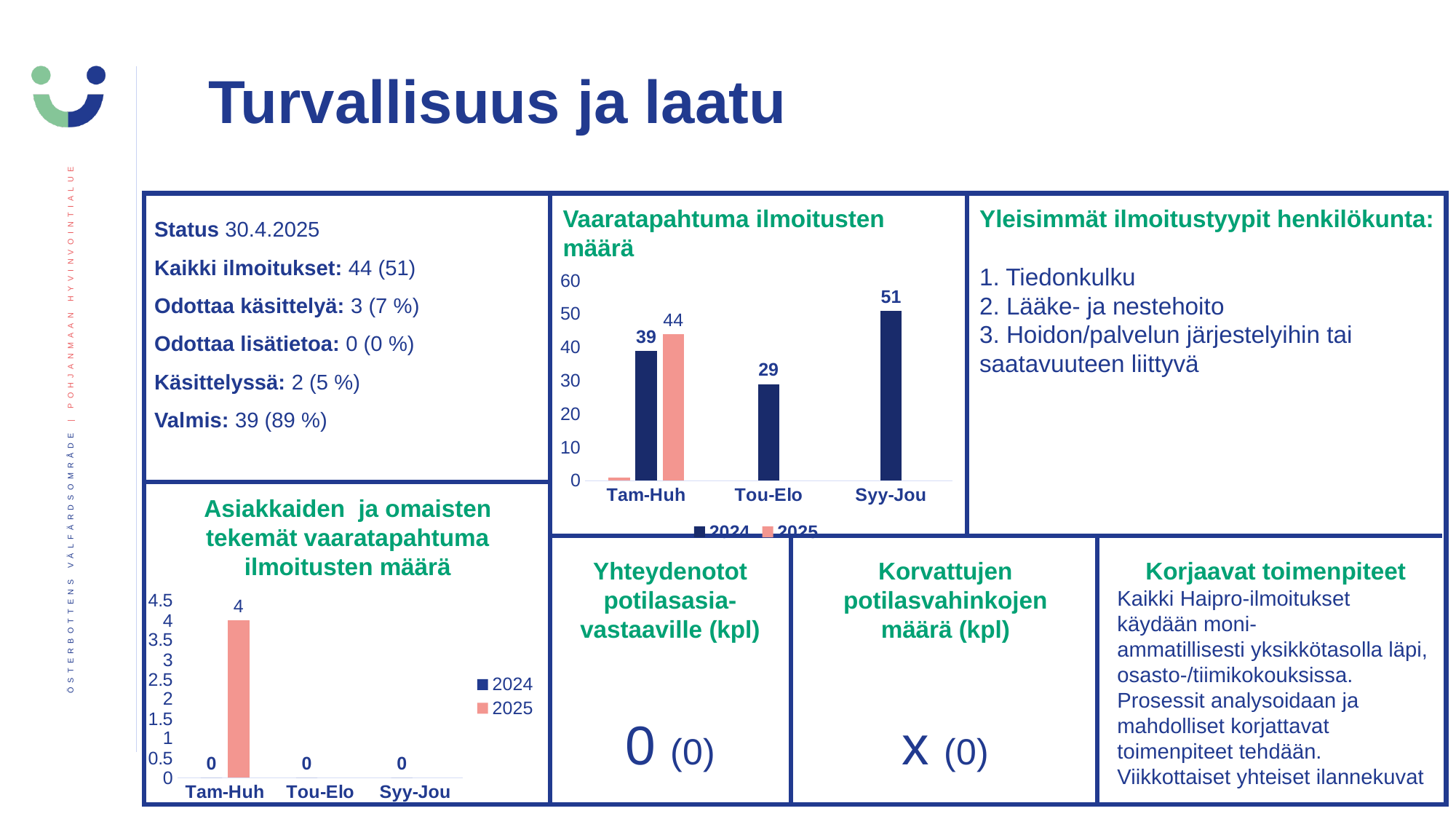
In the chart titled "Vaaratapahtuma ilmoitusten määrä", what is the 2025 value for Tam-Huh? 44 What kind of chart is "Vaaratapahtuma ilmoitusten määrä"? Bar chart In the chart titled "Vaaratapahtuma ilmoitusten määrä", what is the difference between the 2024 values for Syy-Jou and Tou-Elo? 22 In the chart titled "Vaaratapahtuma ilmoitusten määrä", what is the 2024 value for Syy-Jou? 51 In the chart titled "Asiakkaiden ja omaisten tekemät vaaratapahtuma ilmoitusten määrä", what is the 2024 value for Tou-Elo? 0 In the chart titled "Vaaratapahtuma ilmoitusten määrä", which is larger for Tam-Huh: the 2024 value or the 2025 value? 2025 In the chart titled "Vaaratapahtuma ilmoitusten määrä", what is the 2024 value for Tou-Elo? 29 In the chart titled "Asiakkaiden ja omaisten tekemät vaaratapahtuma ilmoitusten määrä", what is the 2025 value for Tam-Huh? 4 How many series does the legend of the chart titled "Asiakkaiden ja omaisten tekemät vaaratapahtuma ilmoitusten määrä" list? 2 In the chart titled "Vaaratapahtuma ilmoitusten määrä", which period has the lowest 2024 value? Tou-Elo In the chart titled "Vaaratapahtuma ilmoitusten määrä", which period has the highest 2024 value? Syy-Jou In the chart titled "Vaaratapahtuma ilmoitusten määrä", how many periods are shown on the x axis? 3